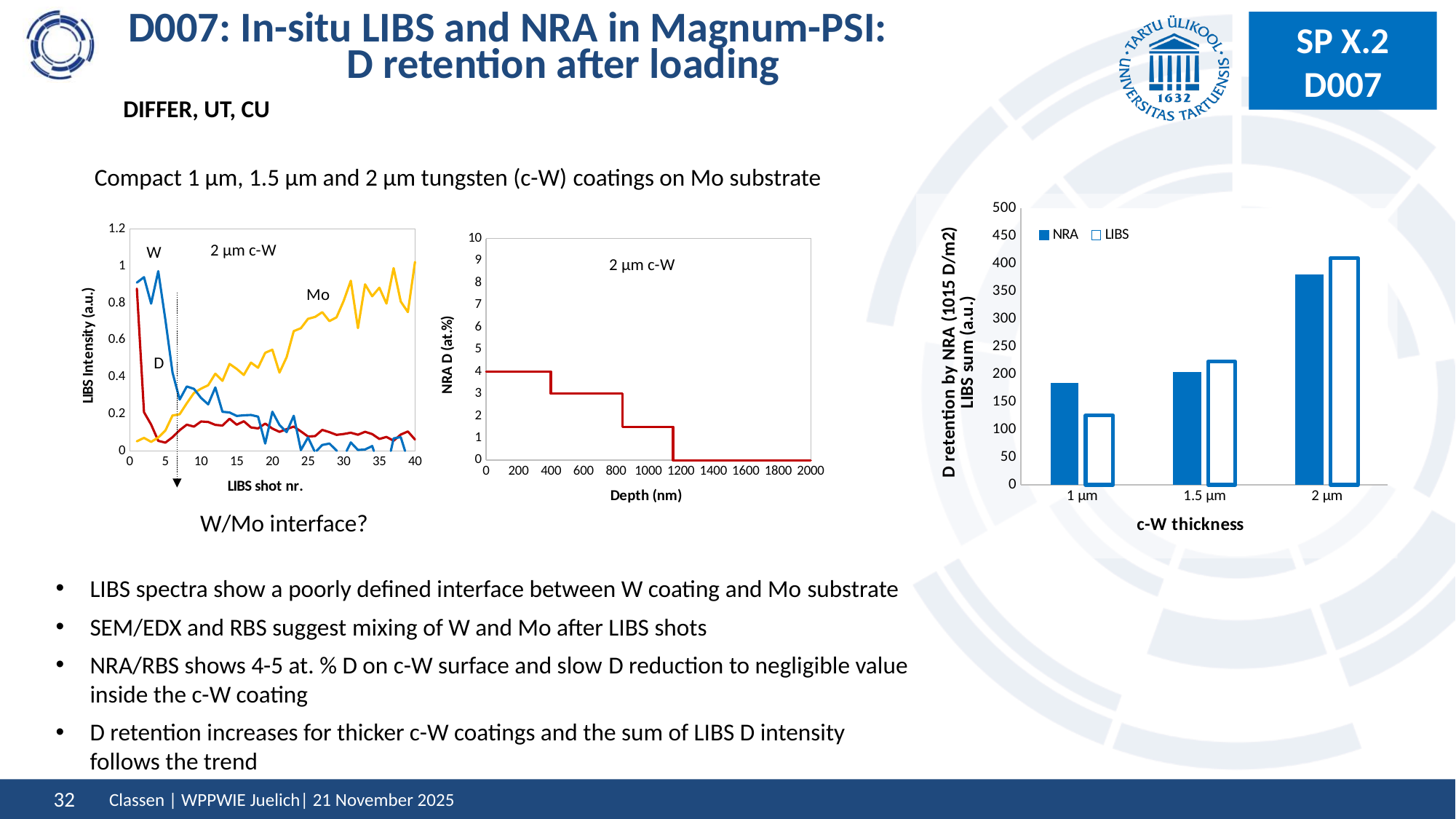
In the bar chart on the right, do the NRA values rise or fall as c-W thickness increases? rise In the bar chart on the right, how many series does the legend list? 2 In the bar chart on the right, how many c-W thickness categories are shown on the x axis? 3 In the middle chart of NRA D versus depth, what is the NRA D value at a depth of 600 nm? 3 In the bar chart on the right, is the NRA value for 1 µm greater or less than 200? less In the left chart of LIBS intensity versus LIBS shot nr., does the Mo curve rise or fall as the shot number increases? rise In the bar chart on the right, at 1 µm, which series has the larger value, NRA or LIBS? NRA In the bar chart on the right, which c-W thickness has the highest NRA value? 2 µm In the bar chart on the right, is the LIBS value for 2 µm greater or less than 400? greater In the bar chart on the right, which c-W thickness has the lowest LIBS value? 1 µm What kind of chart is the chart on the right showing D retention versus c-W thickness? bar chart In the middle chart of NRA D versus depth, what is the NRA D value at a depth of 200 nm? 4